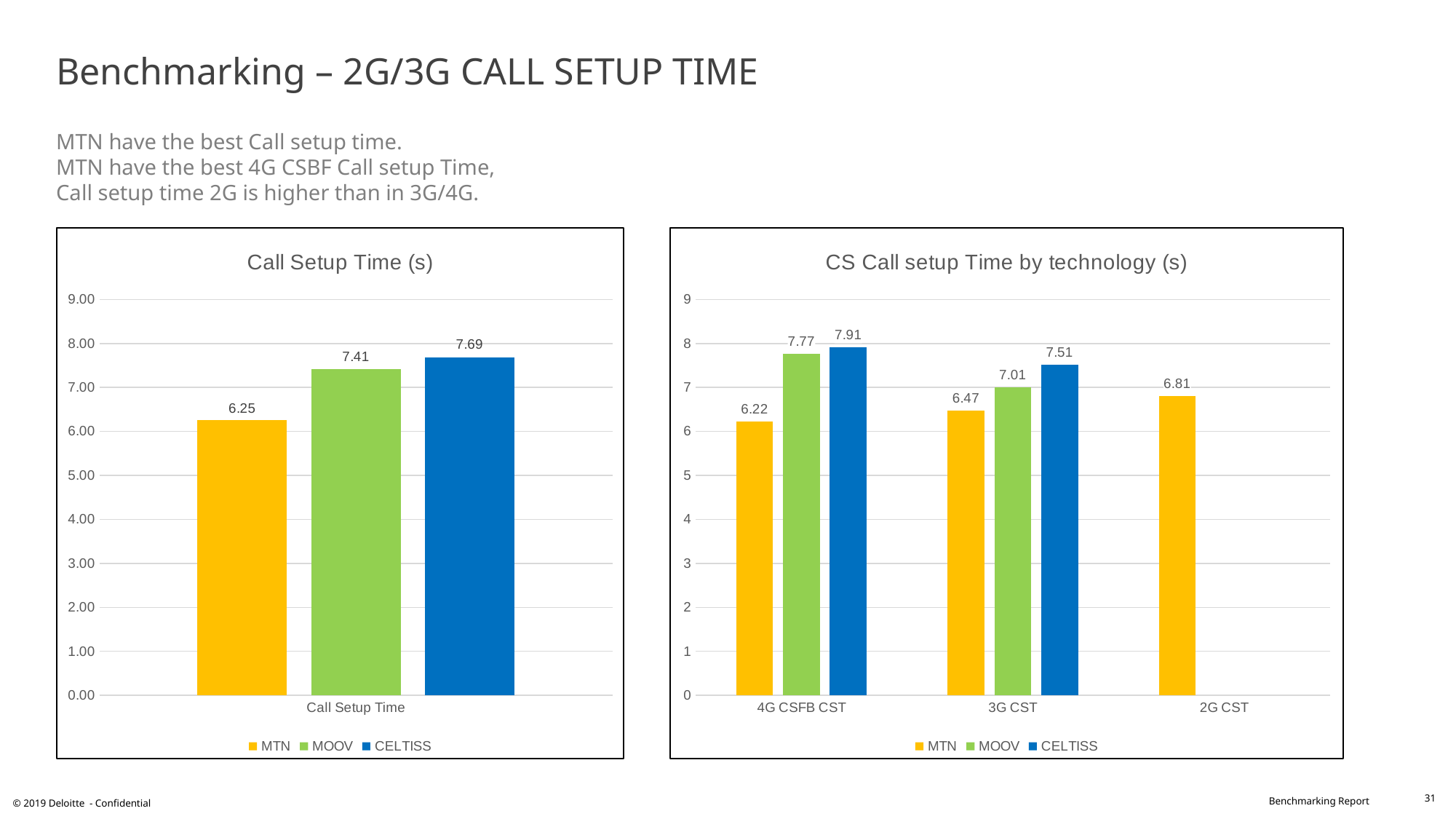
In the 'Call Setup Time (s)' chart, how many series does the legend list? 3 In the 'CS Call setup Time by technology (s)' chart, what is the value for MOOV at 4G CSFB CST? 7.77 In the 'CS Call setup Time by technology (s)' chart, which is larger at 3G CST: MTN or MOOV? MOOV In the 'Call Setup Time (s)' chart, what is the value for MTN? 6.25 In the 'CS Call setup Time by technology (s)' chart, how many technology categories are shown on the x axis? 3 In the 'Call Setup Time (s)' chart, which operator has the lowest call setup time? MTN In the 'CS Call setup Time by technology (s)' chart, which operator has the highest value at 4G CSFB CST? CELTISS What kind of chart is the 'CS Call setup Time by technology (s)' chart? Bar chart In the 'CS Call setup Time by technology (s)' chart, what is the value for CELTISS at 3G CST? 7.51 In the 'CS Call setup Time by technology (s)' chart, what is the value for MTN at 2G CST? 6.81 In the 'Call Setup Time (s)' chart, what is the difference between the CELTISS and MTN values? 1.44 In the 'Call Setup Time (s)' chart, which operator has the highest call setup time? CELTISS